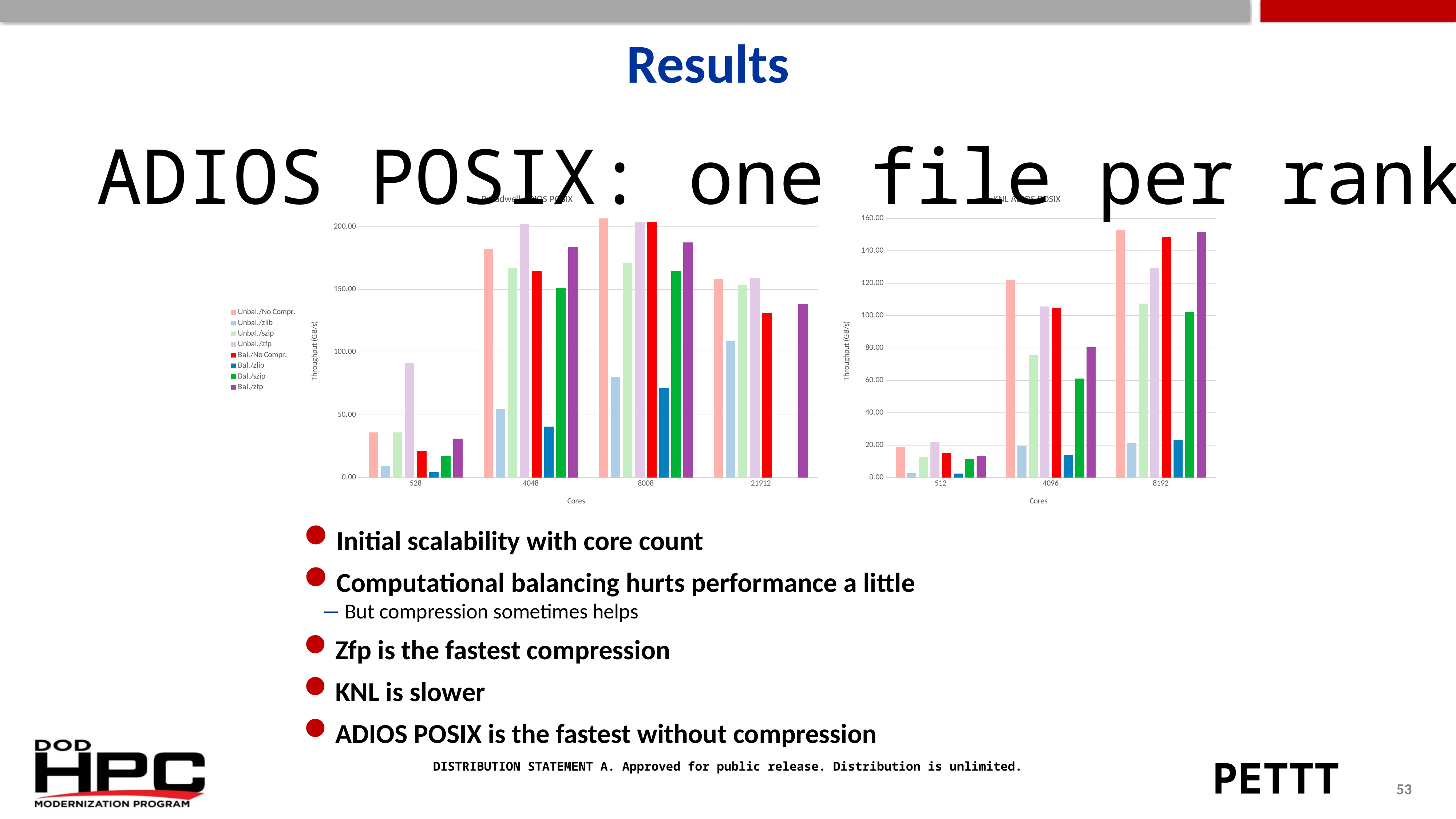
In the left chart at 528 cores, which series has the lowest value? Bal./zlib How many series does the legend list for the charts? 8 In the left chart, at which core count is the Unbal./No Compr. value highest? 8008 In the right chart, is the Bal./zlib value at 8192 cores greater or less than 40? less In the right chart, is the Unbal./No Compr. value at 4096 cores greater or less than 100? greater How many core-count categories are shown on the x axis of the right chart? 3 In the left chart, is the Bal./zlib value at 4048 cores greater or less than 50? less In the right chart, does the Unbal./No Compr. value rise or fall as the core count increases from 512 to 8192? rise In the left chart at 528 cores, which is larger: Unbal./zfp or Unbal./No Compr.? Unbal./zfp How many core-count categories are shown on the x axis of the left chart? 4 What kind of chart is the left chart on the slide? bar chart